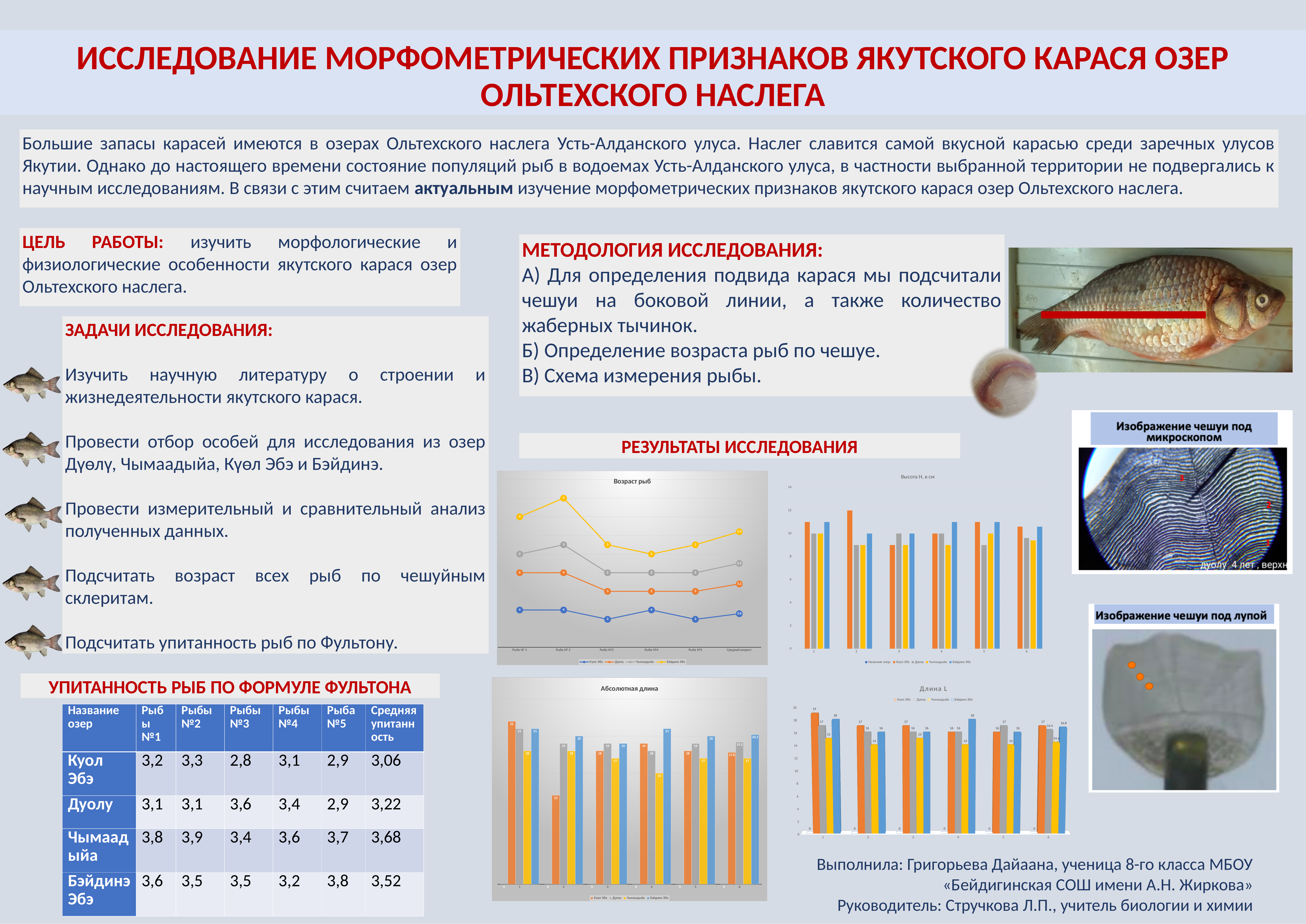
In the "Абсолютная длина" chart, in which group is the Куол Эбэ value lowest? 2 What kind of chart is the "Возраст рыб" chart? line chart In the "Абсолютная длина" chart, what is the value for Куол Эбэ in group 1? 22 In the "Длина L" chart, what is the value for Куол Эбэ in group 1? 19 In the "Возраст рыб" chart, how many categories are shown on the x axis? 6 In the "Абсолютная длина" chart, how many series does the legend list? 4 In the "Возраст рыб" chart, what is the value for Дуолу at "Средний возраст"? 3.2 In the "Высота H, в см" chart, is the value for Куол Эбэ in group 2 greater or less than 10? greater In the "Возраст рыб" chart, which series has the highest values across the fish? Куол Эбэ What kind of chart is the "Абсолютная длина" chart? bar chart In the "Абсолютная длина" chart, what is the difference between Куол Эбэ and Чымаадыйа in group 1? 4 In the "Возраст рыб" chart, what is the value for Куол Эбэ at "Средний возраст"? 3.6